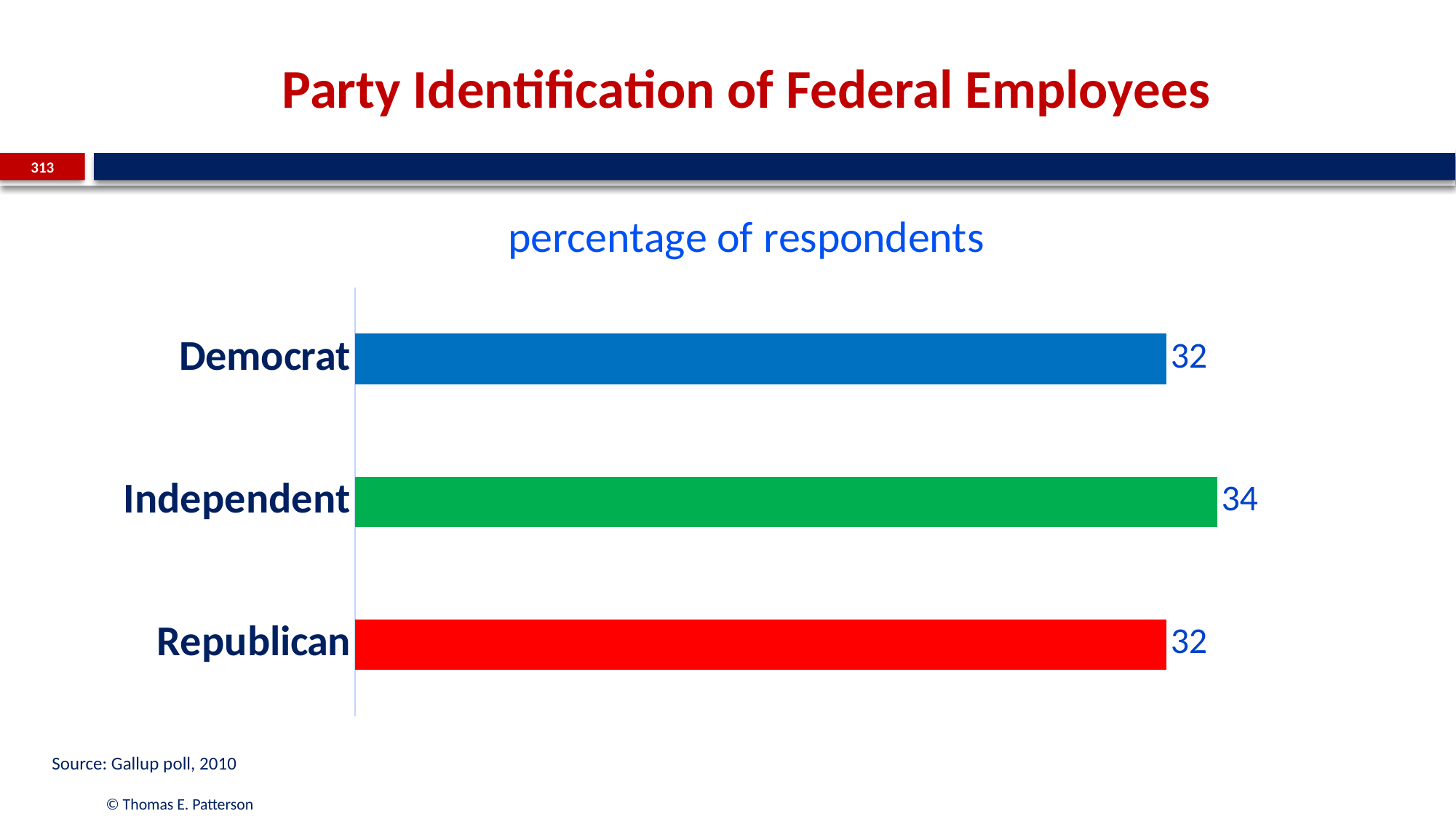
What colour is the bar for Independent? Green Do Democrat and Republican have the same percentage of respondents? Yes How many party identification categories are shown in the chart? 3 What is the difference between the Independent and Democrat percentages? 2 What is the difference between the Independent and Republican percentages? 2 Which is larger, the value for Independent or the value for Republican? Independent What percentage of respondents identify as Democrat? 32 What percentage of respondents identify as Independent? 34 What kind of chart is shown on the slide? Bar chart What is the title of the chart? percentage of respondents Which party identification has the highest percentage of respondents? Independent What percentage of respondents identify as Republican? 32